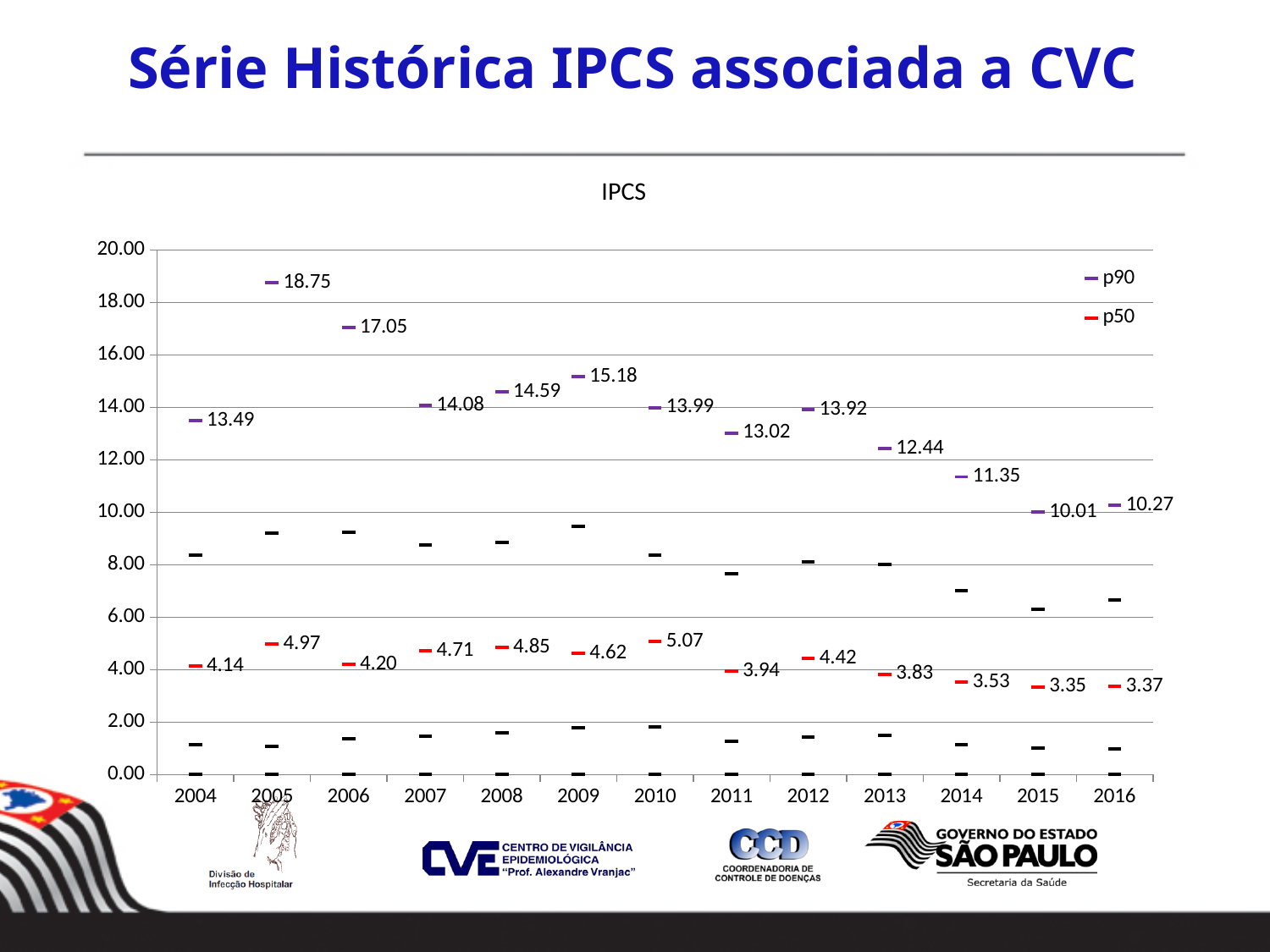
Which is larger, the p90 value in 2006 or in 2009? 2006 What is the difference between the p90 and p50 values in 2005? 13.78 In which year is the p90 value lowest? 2015 By how much did the p90 value fall from 2004 to 2016? 3.22 How many series does the legend list? 2 Does the p90 value rise or fall from 2009 to 2015? fall In which year is the p50 value highest? 2010 What is the p90 value for 2016? 10.27 What is the p50 value for 2010? 5.07 What is the p90 value for 2005? 18.75 How many years are shown on the x axis? 13 In which year is the p90 value highest? 2005